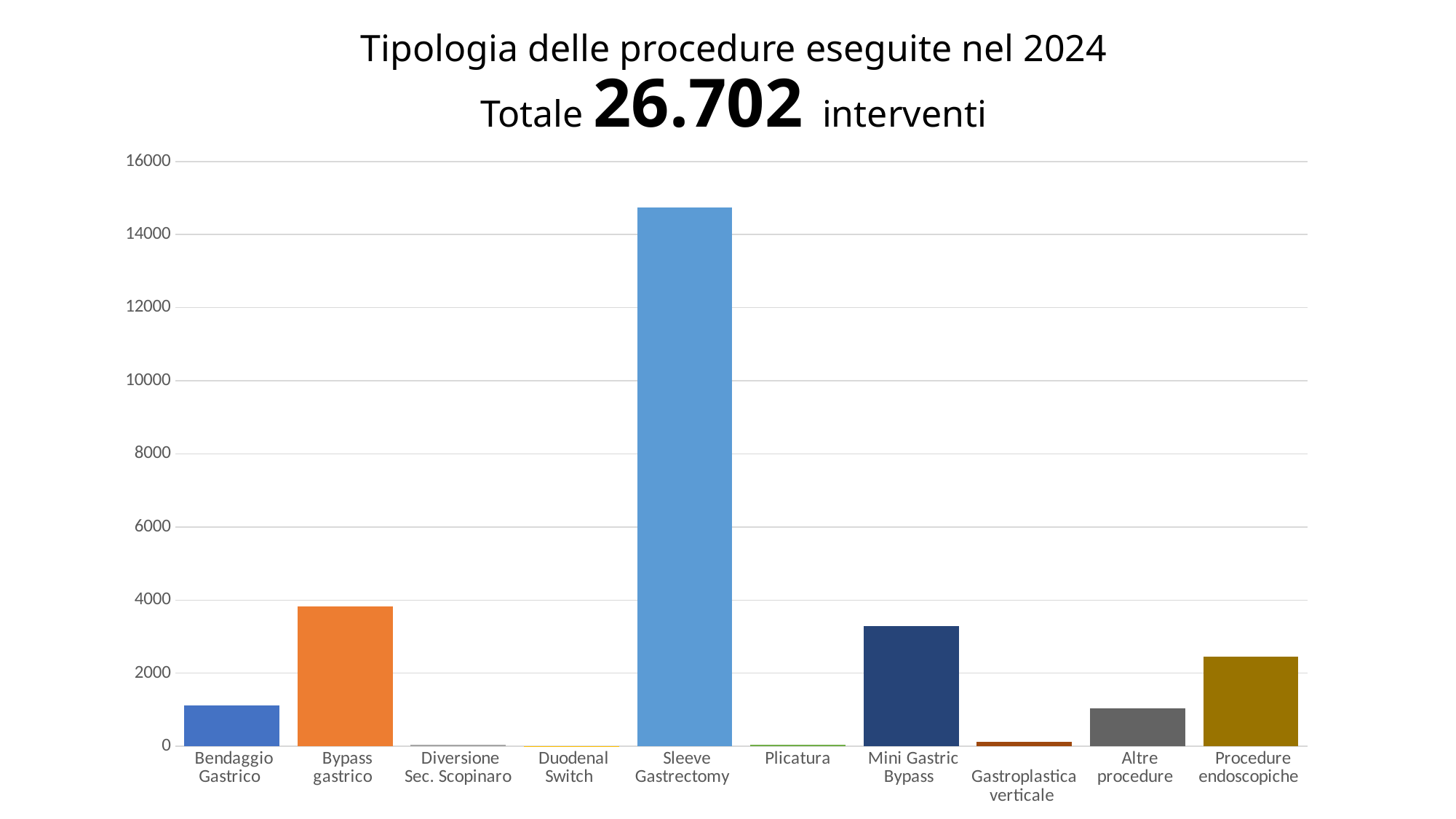
What is the title of the chart? Tipologia delle procedure eseguite nel 2024 Which is larger, the value for Procedure endoscopiche or the value for Bendaggio Gastrico? Procedure endoscopiche Is the value for Bypass gastrico greater or less than 4000? less Which is larger, the value for Bypass gastrico or the value for Mini Gastric Bypass? Bypass gastrico Is the value for Procedure endoscopiche greater or less than 2000? greater Is the value for Bendaggio Gastrico greater or less than 2000? less How many procedure categories are shown on the x axis? 10 What kind of chart is shown on the slide? bar chart What total number of interventions is stated above the chart? 26.702 Which procedure has the highest number of interventions? Sleeve Gastrectomy